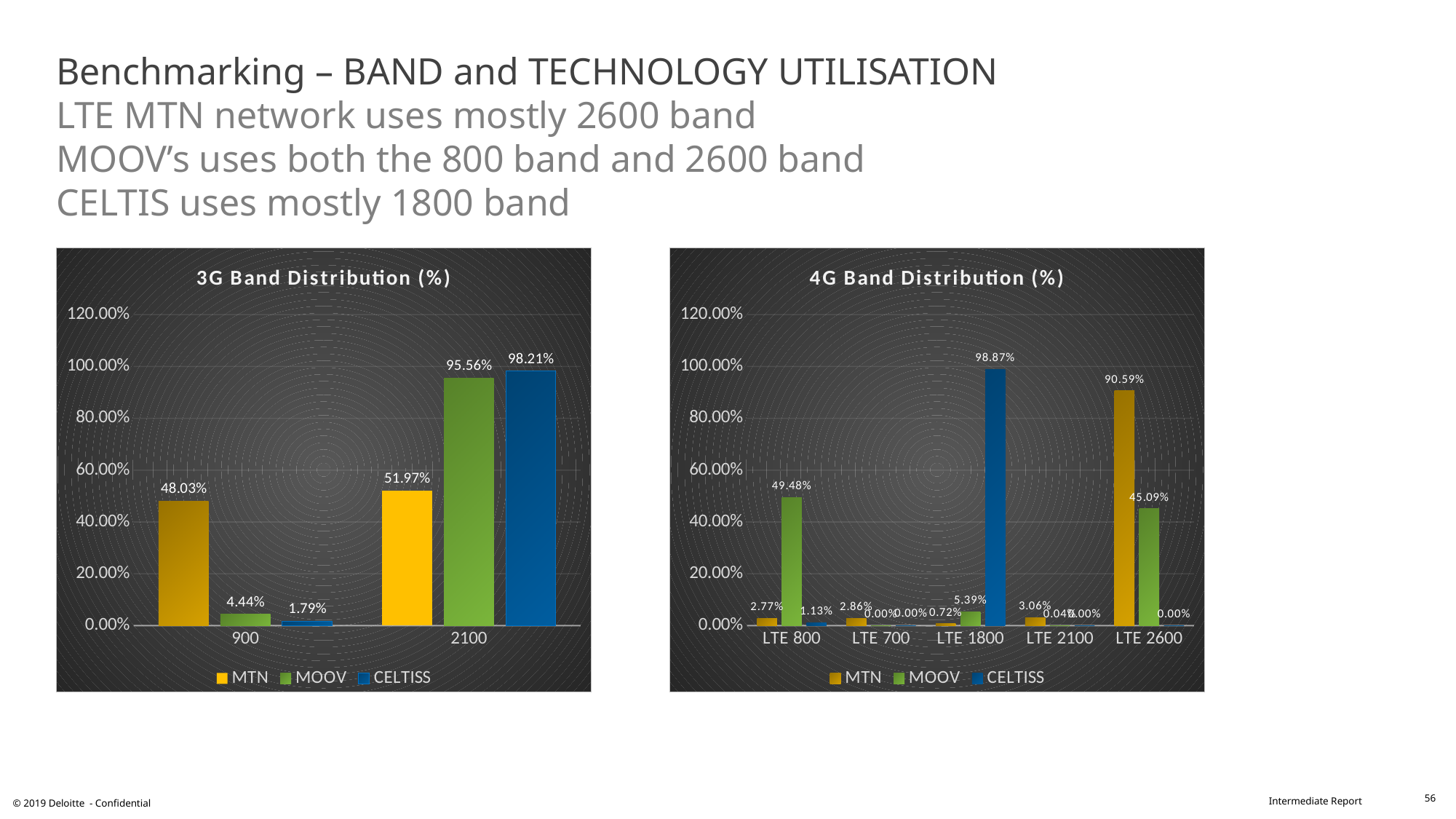
In the 3G Band Distribution (%) chart, what is the value for CELTISS in the 2100 band? 98.21% In the 3G Band Distribution (%) chart, which series has the highest value in the 2100 band? CELTISS In the 3G Band Distribution (%) chart, what is the difference between MTN's 2100 value and its 900 value? 3.94% In the 4G Band Distribution (%) chart, is MTN's value in LTE 2600 larger or smaller than MOOV's value in LTE 2600? larger In the 4G Band Distribution (%) chart, what is the value for MOOV in LTE 800? 49.48% In the 4G Band Distribution (%) chart, what is the difference between MTN's and MOOV's values in LTE 2600? 45.50% In the 3G Band Distribution (%) chart, what is the value for MTN in the 900 band? 48.03% In the 4G Band Distribution (%) chart, what is the value for CELTISS in LTE 1800? 98.87% In the 4G Band Distribution (%) chart, which band has the highest value for MTN? LTE 2600 In the 4G Band Distribution (%) chart, how many band categories are shown on the x axis? 5 How many series does the legend of the 4G Band Distribution (%) chart list? 3 In the 3G Band Distribution (%) chart, how many band categories are shown on the x axis? 2